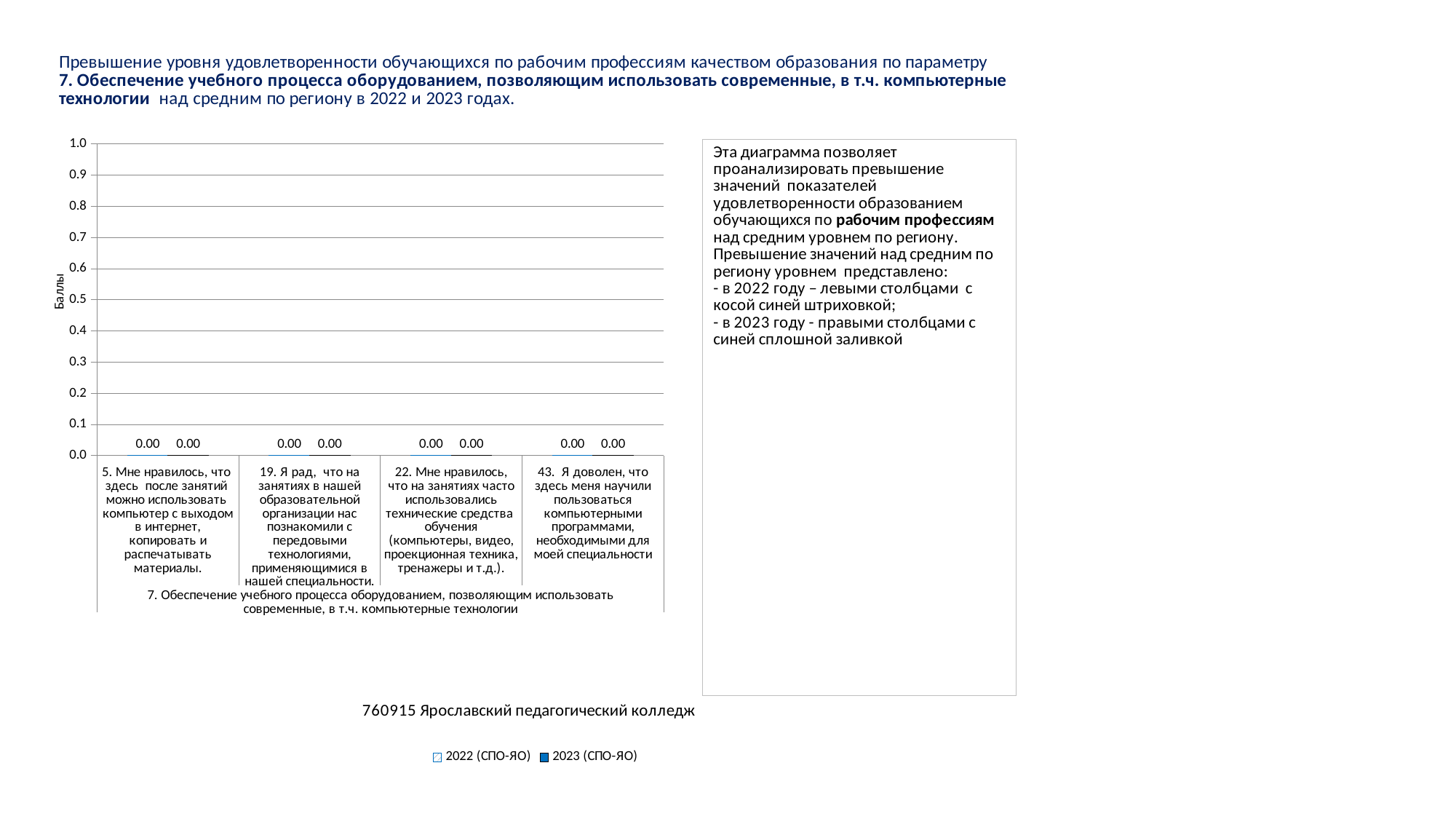
What is the value for 2023 (СПО-ЯО) for category "19. Я рад, что на занятиях в нашей образовательной организации нас познакомили с передовыми технологиями, применяющимися в нашей специальности."? 0.00 What is the value for 2022 (СПО-ЯО) for category "5. Мне нравилось, что здесь после занятий можно использовать компьютер с выходом в интернет, копировать и распечатывать материалы."? 0.00 What is the difference between the 2022 (СПО-ЯО) and 2023 (СПО-ЯО) values for category "5. Мне нравилось, что здесь после занятий можно использовать компьютер с выходом в интернет, копировать и распечатывать материалы."? 0.00 What kind of chart is shown on the slide? bar chart How many categories are shown on the x axis of the chart? 4 What is the highest value shown on the vertical axis of the chart? 1.0 What are the two series listed in the chart legend? 2022 (СПО-ЯО) and 2023 (СПО-ЯО) What is the value for 2023 (СПО-ЯО) for category "43. Я доволен, что здесь меня научили пользоваться компьютерными программами, необходимыми для моей специальности"? 0.00 What is the label of the vertical axis of the chart? Баллы Is the value for 2023 (СПО-ЯО) for category "22. Мне нравилось, что на занятиях часто использовались технические средства обучения (компьютеры, видео, проекционная техника, тренажеры и т.д.)." greater or less than 0.5? less How many series does the chart legend list? 2 What is the value for 2022 (СПО-ЯО) for category "22. Мне нравилось, что на занятиях часто использовались технические средства обучения (компьютеры, видео, проекционная техника, тренажеры и т.д.)."? 0.00